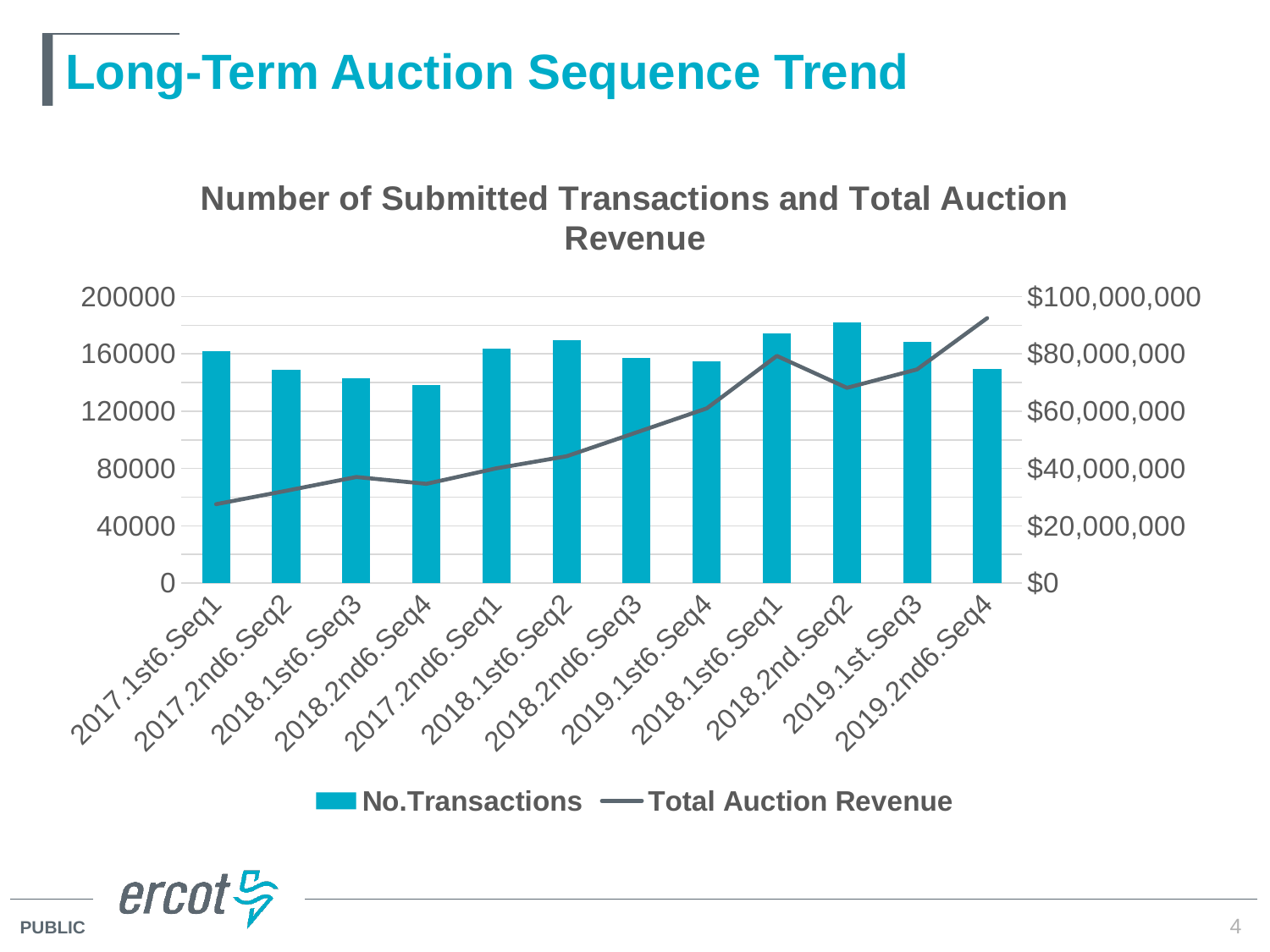
How many series does the legend list? 2 Is the Total Auction Revenue for 2017.1st6.Seq1 greater or less than $40,000,000? less Which auction sequence has the lowest number of transactions? 2018.2nd6.Seq4 Does the Total Auction Revenue line generally rise or fall from left to right across the auction sequences? rise How many auction sequence categories are shown on the x axis? 12 Which auction sequence has the lowest Total Auction Revenue? 2017.1st6.Seq1 Which auction sequence has the highest Total Auction Revenue? 2019.2nd6.Seq4 Is the number of transactions for 2018.2nd.Seq2 greater or less than 160000? greater Is the Total Auction Revenue for 2019.2nd6.Seq4 greater or less than $80,000,000? greater Which has more transactions, 2018.1st6.Seq1 or 2018.2nd6.Seq4? 2018.1st6.Seq1 Which auction sequence has the highest number of transactions? 2018.2nd.Seq2 What kind of chart is shown on the slide? A combined bar and line chart